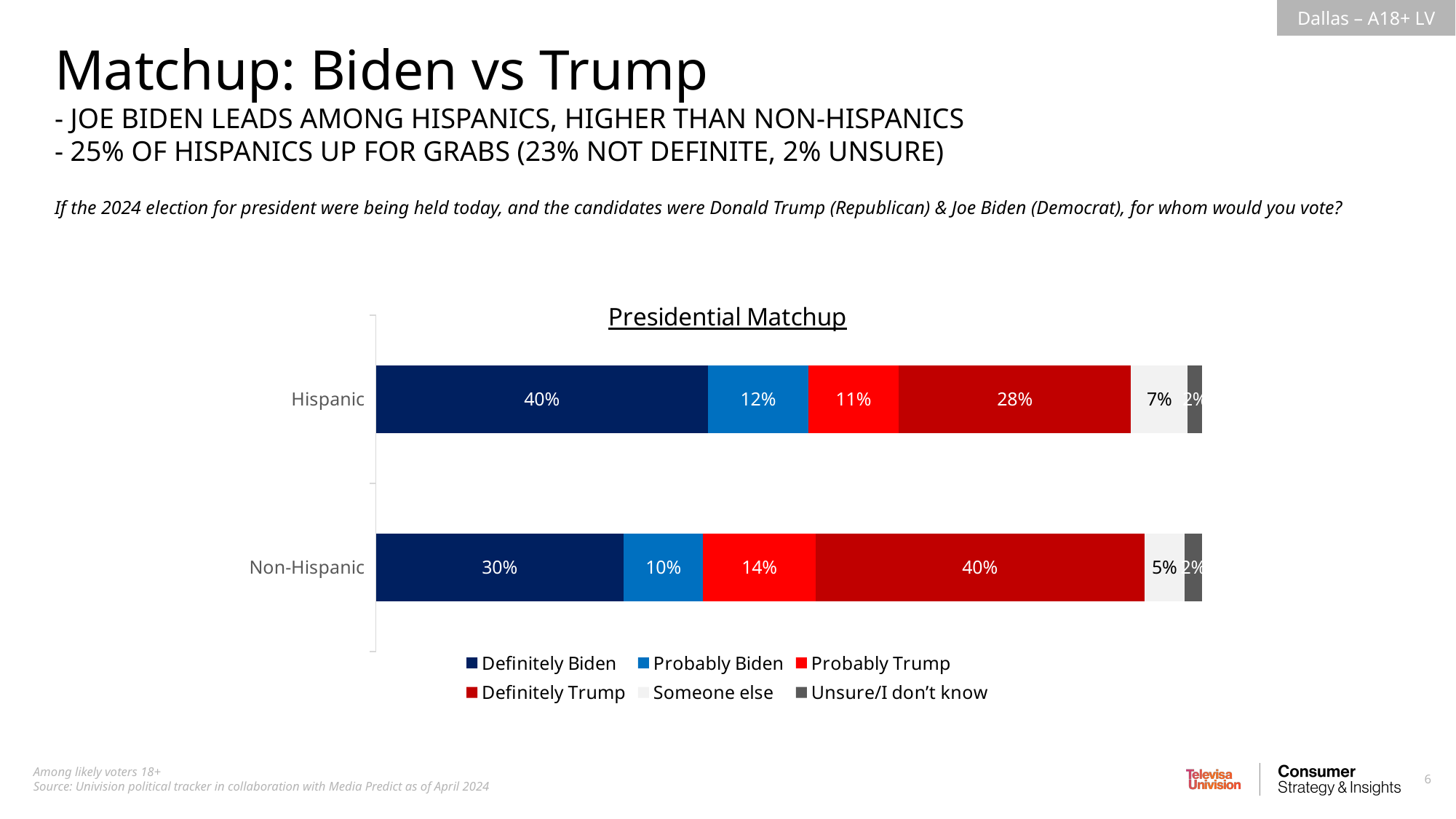
What percentage of Non-Hispanic respondents said Definitely Trump? 40% What type of chart is shown? Stacked bar chart What percentage of Non-Hispanic respondents said Someone else? 5% Which response category is the smallest for Non-Hispanic respondents? Unsure/I don't know How many groups are shown on the chart? 2 What is the difference between the Definitely Biden share for Hispanic and Non-Hispanic respondents? 10% What percentage of Hispanic respondents said Definitely Biden? 40% Which group has a larger Definitely Trump share, Hispanic or Non-Hispanic? Non-Hispanic Which group has a larger Probably Biden share, Hispanic or Non-Hispanic? Hispanic Which response category is the largest for Hispanic respondents? Definitely Biden How many series does the legend list? 6 What percentage of Hispanic respondents said Probably Trump? 11%